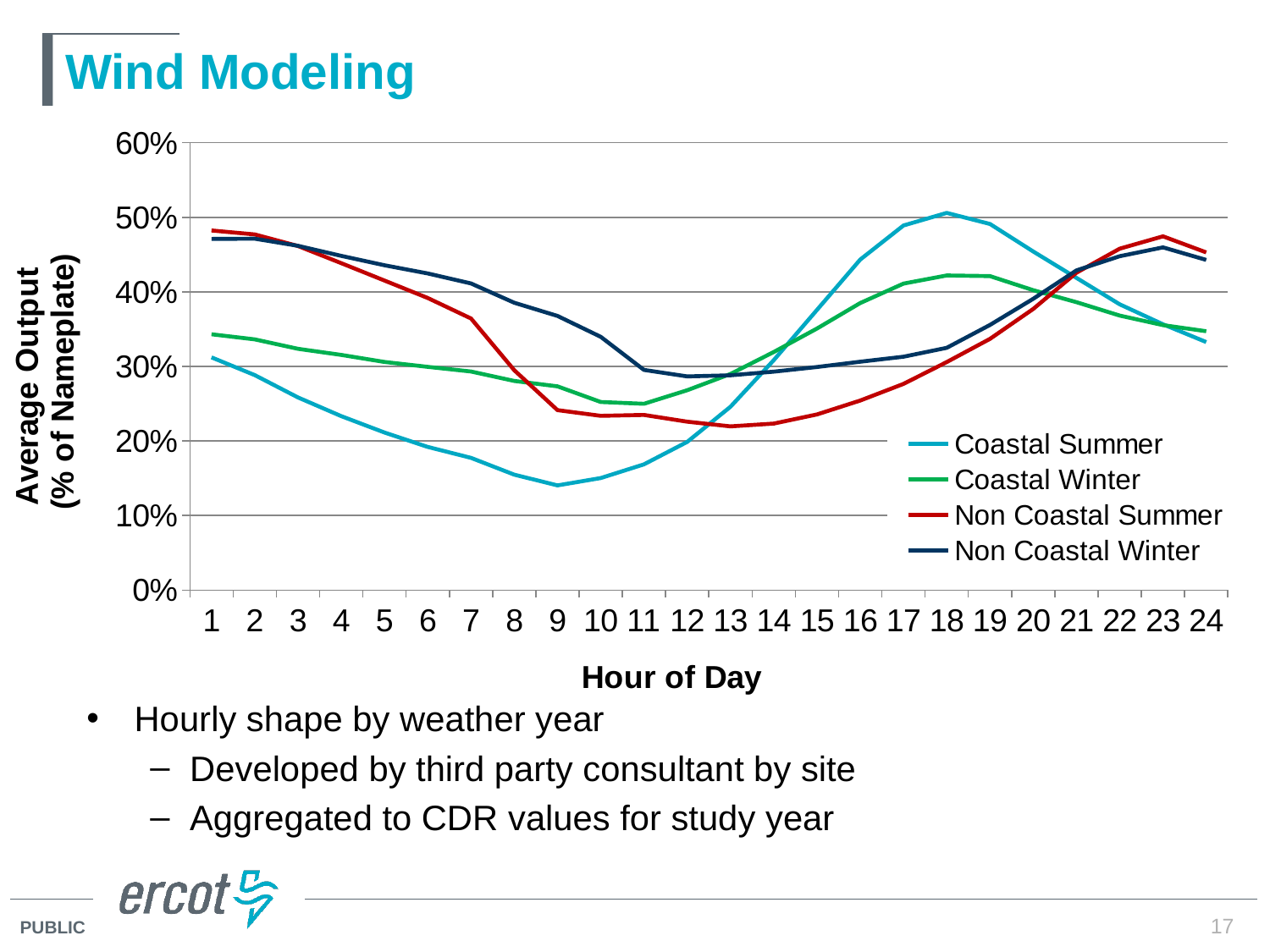
How many hours are plotted along the x axis? 24 How many series does the legend list? 4 At hour 13, which is larger: Non Coastal Winter or Non Coastal Summer? Non Coastal Winter At which hour of the day does the Coastal Summer series reach its lowest value? 9 At which hour of the day does the Coastal Summer series reach its highest value? 18 Is the Coastal Winter value at hour 11 greater or less than 30%? less At hour 1, which is larger: Non Coastal Summer or Coastal Summer? Non Coastal Summer What kind of chart is shown on the slide? Line chart Is the Non Coastal Summer value at hour 1 greater or less than 40%? greater Does the Coastal Summer series rise or fall from hour 1 to hour 9? Fall Is the Coastal Summer value at hour 18 greater or less than 40%? greater